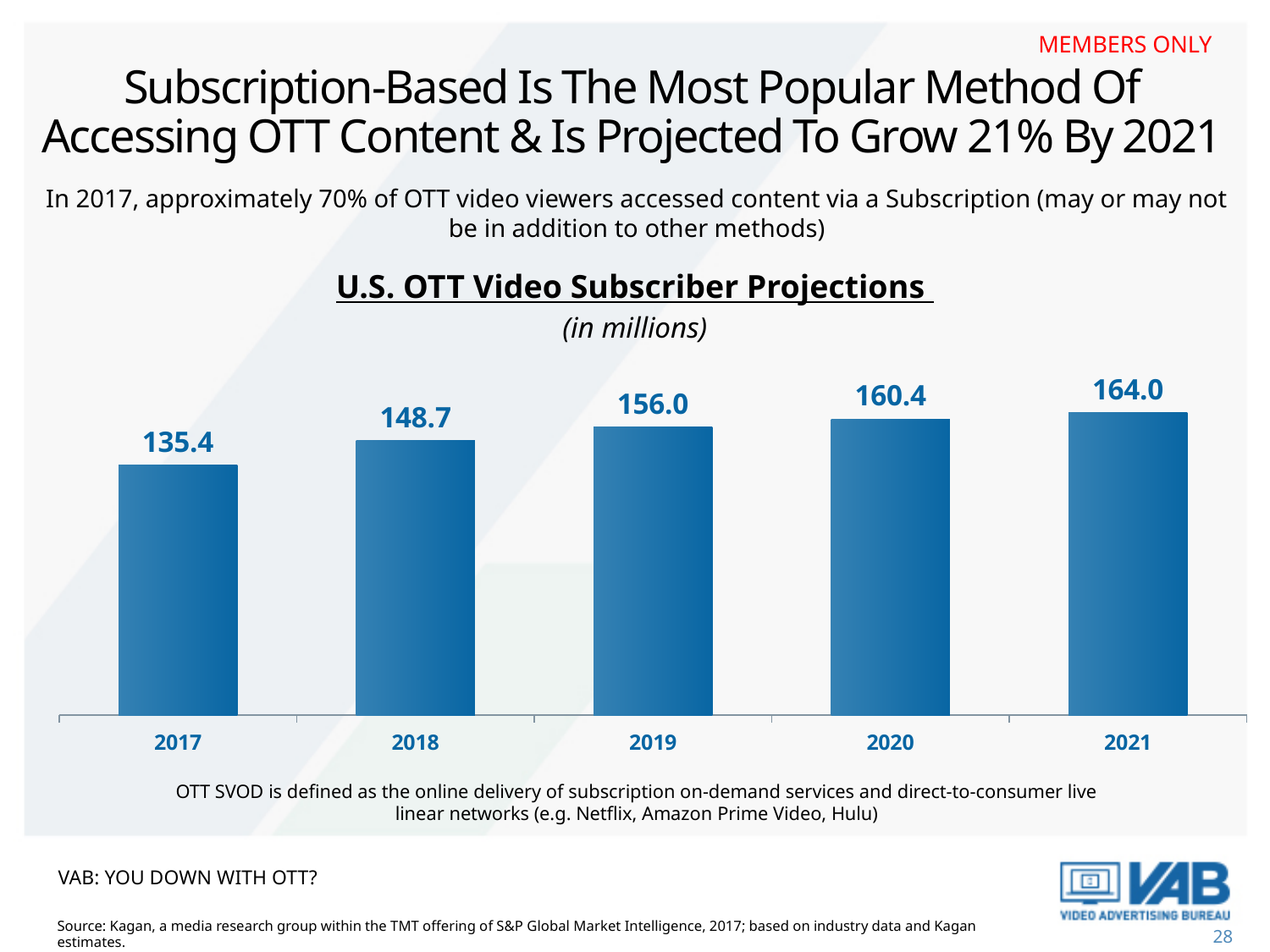
How many years are shown on the x axis of the chart? 5 Which year has the highest projected number of U.S. OTT video subscribers? 2021 What is the title of the chart on the slide? U.S. OTT Video Subscriber Projections What is the projected number of U.S. OTT video subscribers (in millions) for 2019? 156.0 What is the difference in projected U.S. OTT video subscribers (in millions) between 2018 and 2017? 13.3 Which year has a larger projected subscriber value, 2018 or 2020? 2020 What is the difference in projected U.S. OTT video subscribers (in millions) between 2021 and 2017? 28.6 Do the projected subscriber values rise or fall from 2017 to 2021? Rise What is the projected number of U.S. OTT video subscribers (in millions) for 2021? 164.0 Which year has the lowest projected number of U.S. OTT video subscribers? 2017 What is the projected number of U.S. OTT video subscribers (in millions) for 2017? 135.4 What kind of chart is used to show the U.S. OTT Video Subscriber Projections? Bar chart